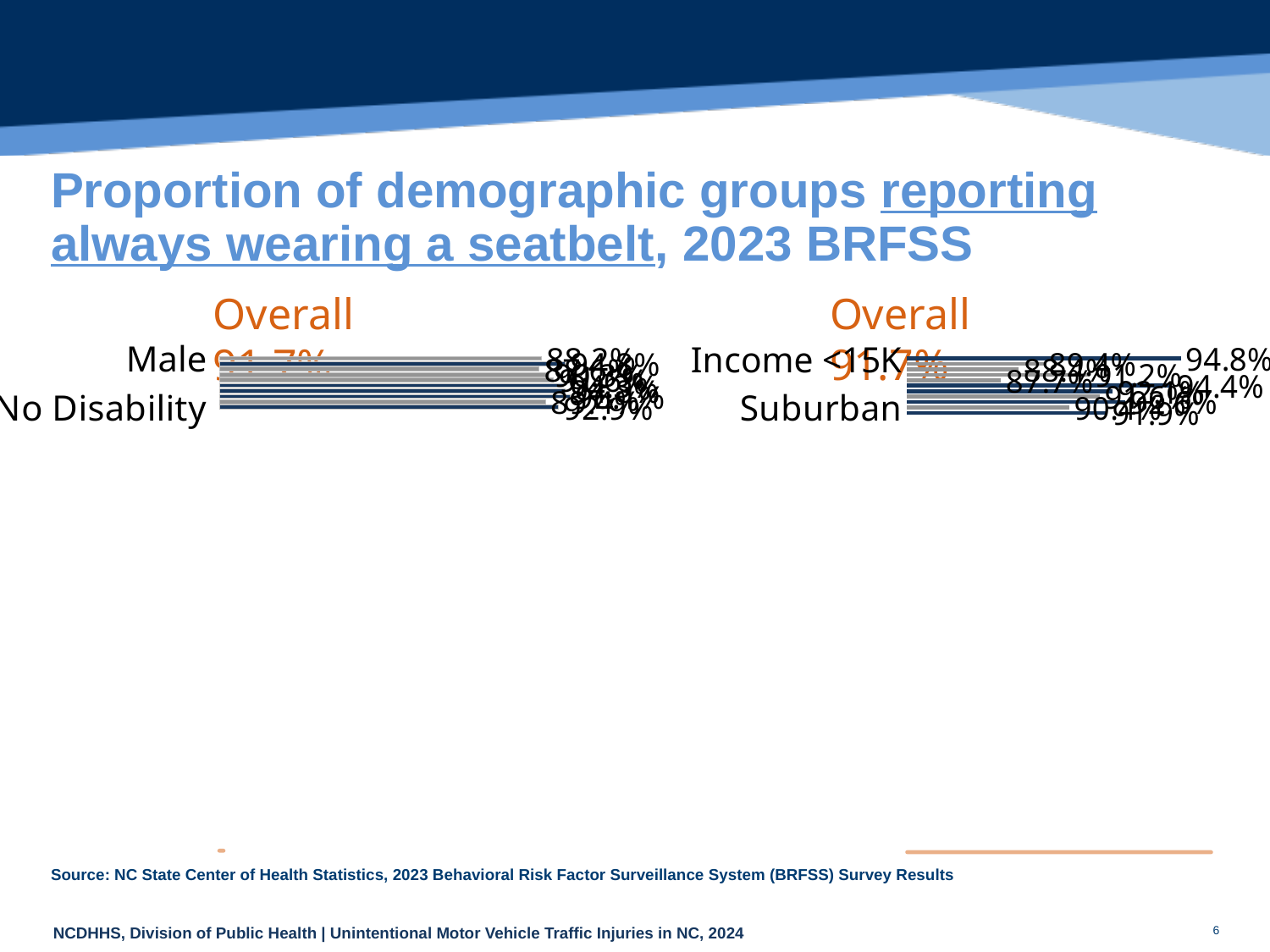
In the right chart, which category label appears at the bottom of the category axis? Suburban What kind of chart is the left chart on the slide? bar chart In the right chart, what is the value for Overall? 91.7% In the left chart, which category label appears at the bottom of the category axis? No Disability What kind of chart is the right chart on the slide? bar chart In the left chart, what is the value for Overall? 91.7%